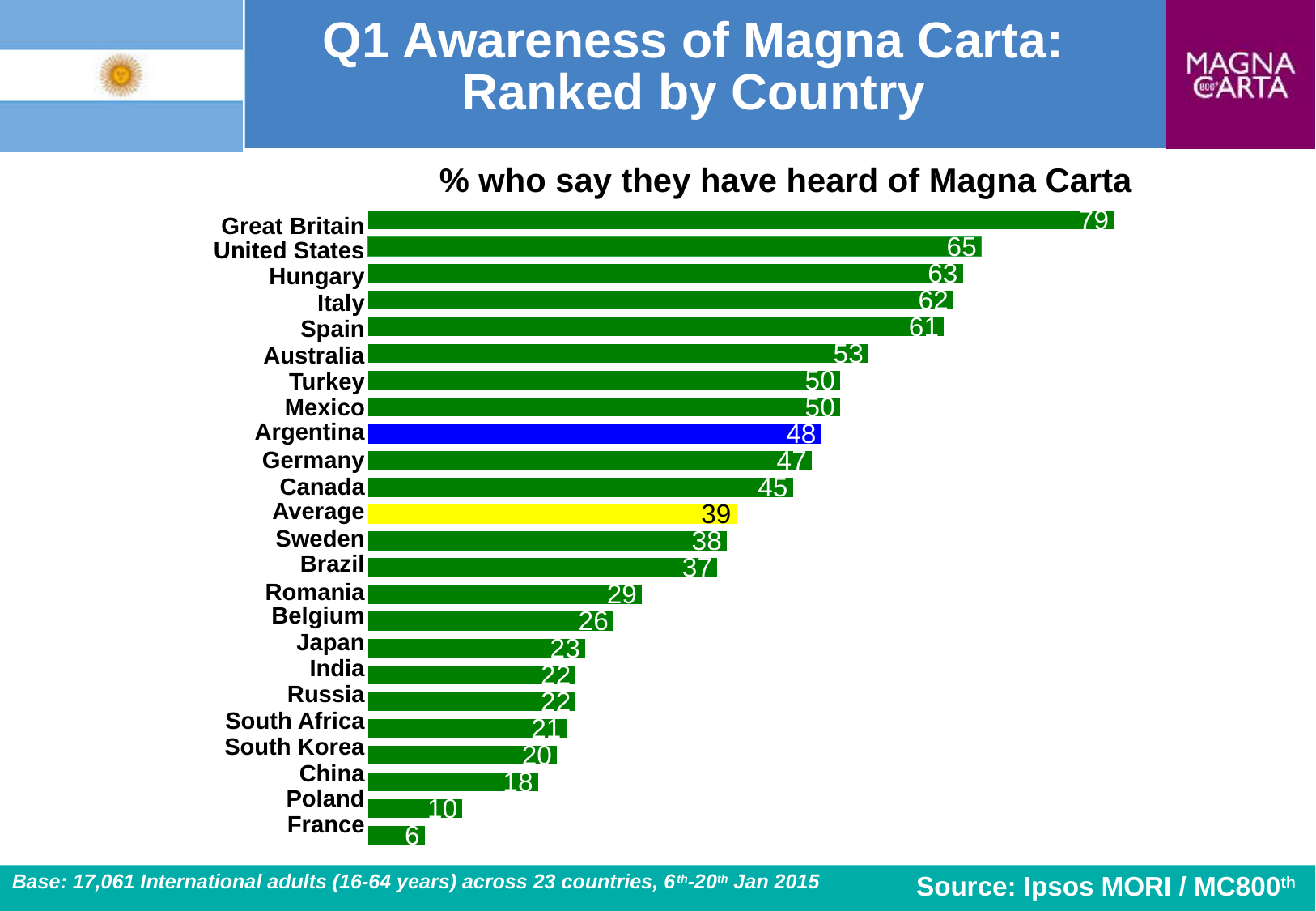
Which has a larger value, Australia or Canada? Australia Which has a larger value, Poland or China? China Which country has the lowest value? France What is the difference between the values for Argentina and the Average? 9 Which country has the highest value? Great Britain What is the value for Argentina? 48 What is the difference between the values for Great Britain and the United States? 14 What type of chart is shown on the slide? Bar chart What is the value for Great Britain? 79 How many bars are plotted in the chart, including the Average bar? 24 What colour is the Argentina bar? Blue What is the value shown for the Average bar? 39